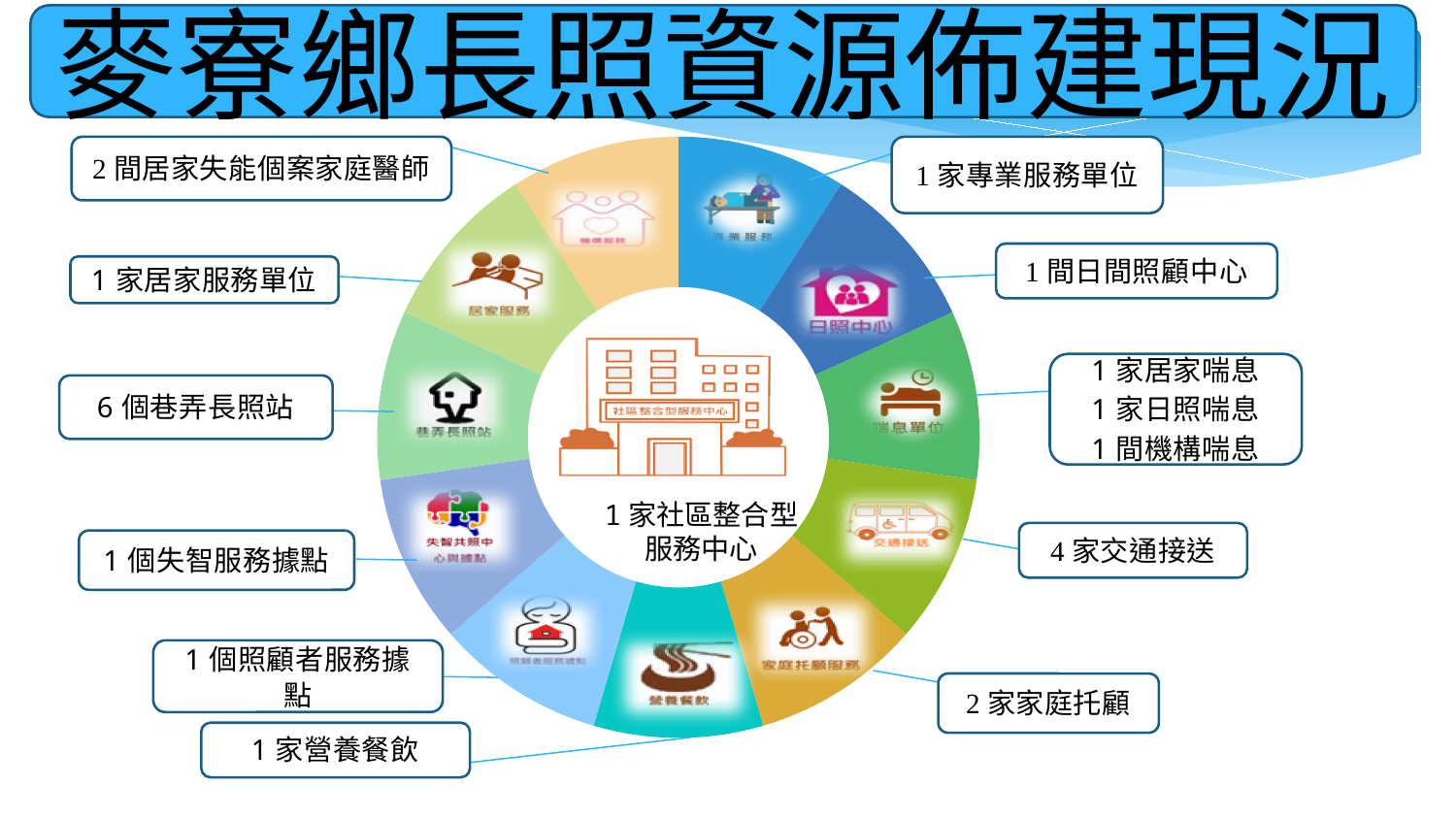
How many 家庭托顧 providers are listed? 2 家 Which is larger: the number of 交通接送 providers or the number of 家庭托顧 providers? 交通接送 Which resource type has the largest count on the slide? 巷弄長照站 How many 巷弄長照站 does the slide report for 麥寮鄉? 6 個 How many 居家失能個案家庭醫師 are listed? 2 間 What kind of diagram is used to present the long-term care resources? ring (donut) diagram How many 日間照顧中心 are listed? 1 間 What is the difference between the number of 巷弄長照站 and the number of 交通接送 providers? 2 How many 交通接送 providers are listed on the slide? 4 家 How many 社區整合型服務中心 are shown at the centre of the ring? 1 家 What is the title of the slide? 麥寮鄉長照資源佈建現況 How many segments make up the ring diagram around the centre? 11